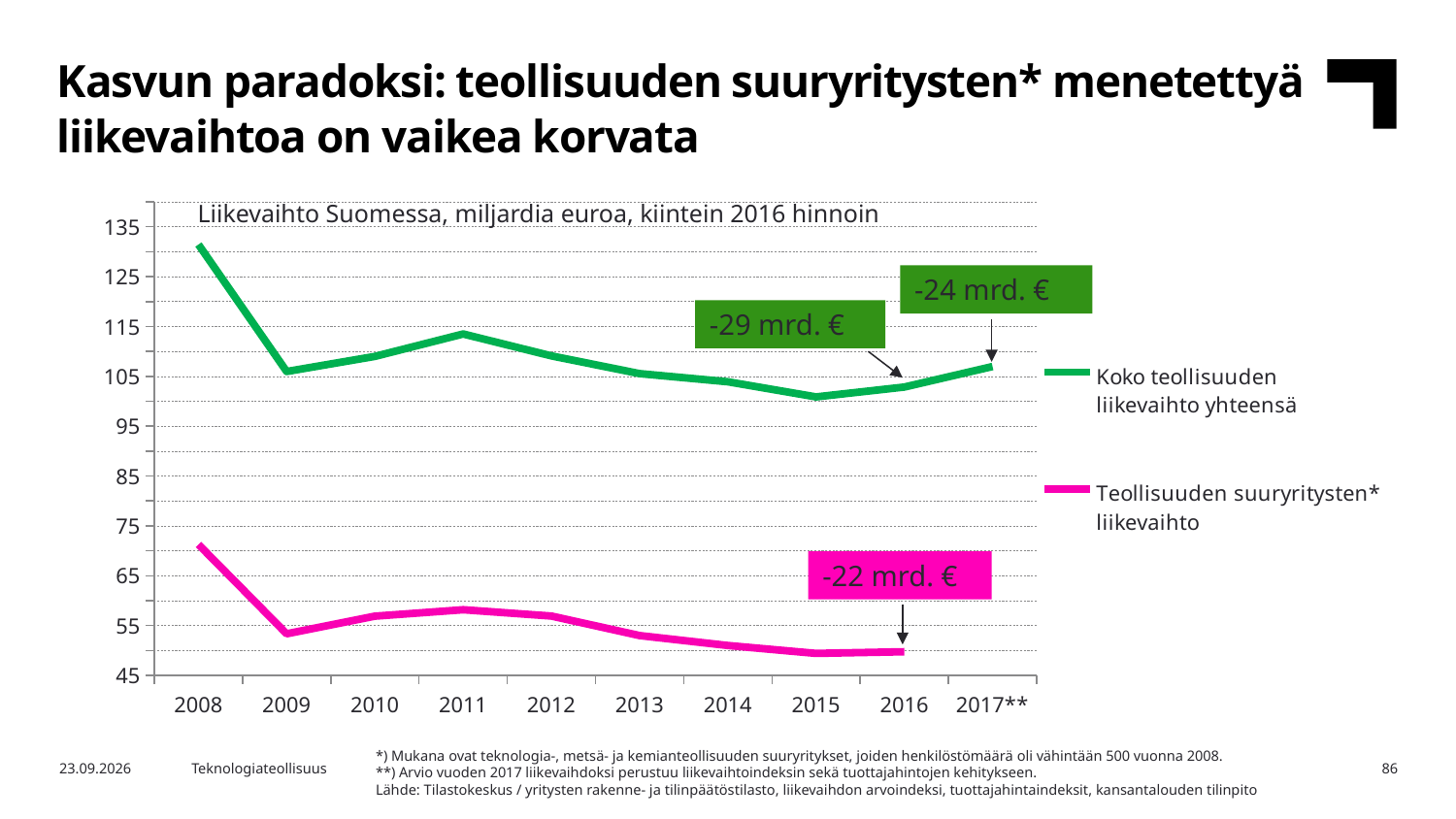
In which year is 'Koko teollisuuden liikevaihto yhteensä' at its highest? 2008 What kind of chart is shown on the slide? line chart What is the title of the chart? Liikevaihto Suomessa, miljardia euroa, kiintein 2016 hinnoin Is the value for 'Teollisuuden suuryritysten* liikevaihto' in 2016 greater or less than 55? less Is the value for 'Koko teollisuuden liikevaihto yhteensä' in 2008 greater or less than 125? greater How many years are shown on the x axis? 10 In which year is 'Koko teollisuuden liikevaihto yhteensä' at its lowest? 2015 Which colour is used for the series 'Teollisuuden suuryritysten* liikevaihto'? pink (magenta) Which series has the higher value in 2012, 'Koko teollisuuden liikevaihto yhteensä' or 'Teollisuuden suuryritysten* liikevaihto'? Koko teollisuuden liikevaihto yhteensä Does 'Koko teollisuuden liikevaihto yhteensä' rise or fall from 2008 to 2009? fall How many series does the legend list? 2 In which year is 'Teollisuuden suuryritysten* liikevaihto' at its highest? 2008